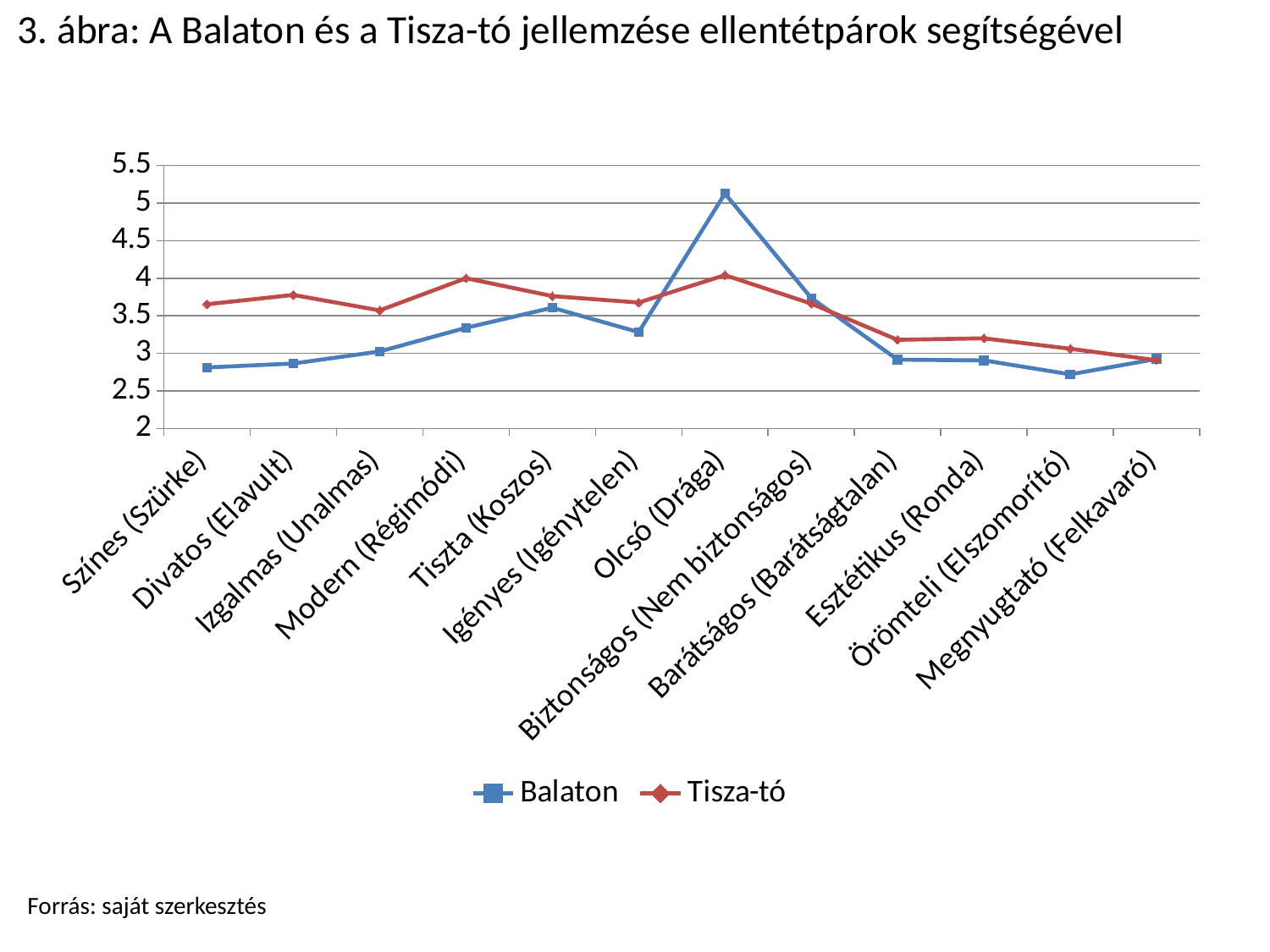
Which colour is used for the Tisza-tó series? red Is the Balaton value for Színes (Szürke) greater or less than 3? less How many series does the legend list? 2 For which category does the Balaton series reach its highest value? Olcsó (Drága) For which category does the Balaton series have its lowest value? Örömteli (Elszomorító) Which series has the higher value for Színes (Szürke), Balaton or Tisza-tó? Tisza-tó How many categories are plotted along the x axis? 12 Is the Balaton value for Olcsó (Drága) greater or less than 5? greater Which series has the higher value for Olcsó (Drága), Balaton or Tisza-tó? Balaton Does the Balaton series rise or fall from Színes (Szürke) to Tiszta (Koszos)? rise What kind of chart is shown on the slide? line chart Is the Tisza-tó value for Modern (Régimódi) greater or less than 3.5? greater